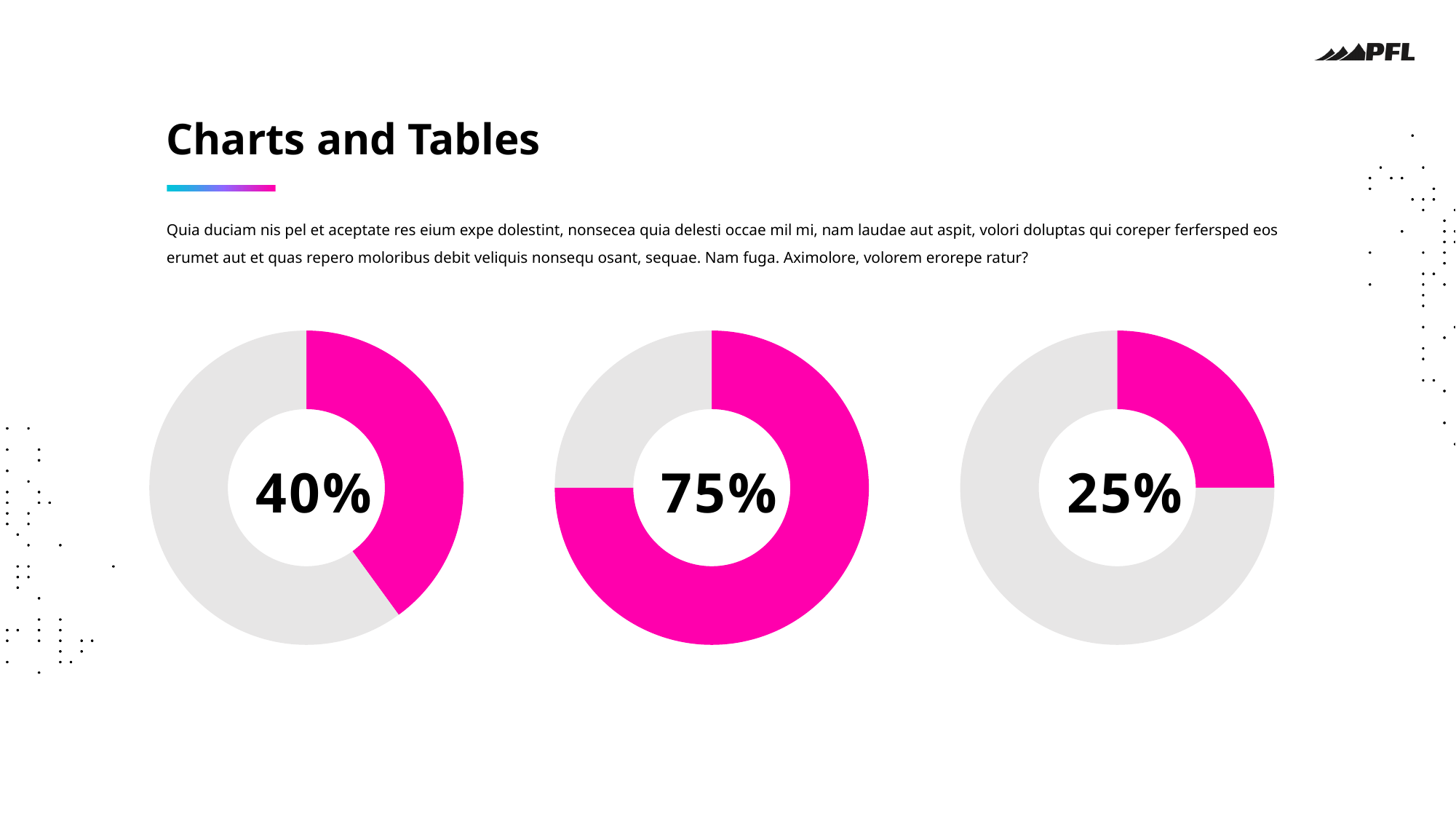
What percentage is shown in the right doughnut chart? 25% What colour is the filled portion of each doughnut chart? Pink (magenta) What is the difference between the percentage in the middle chart and the percentage in the right chart? 50% What is the difference between the percentage in the left chart and the percentage in the right chart? 15% What is the title of the slide containing the doughnut charts? Charts and Tables Which of the three doughnut charts shows the highest percentage? The middle chart (75%) How many doughnut charts are on the slide? 3 Which of the three doughnut charts shows the lowest percentage? The right chart (25%) Which is larger, the percentage in the left chart or the percentage in the right chart? The left chart (40%) What percentage is shown in the middle doughnut chart? 75% What percentage is shown in the left doughnut chart? 40% What kind of chart is used on this slide? Doughnut chart